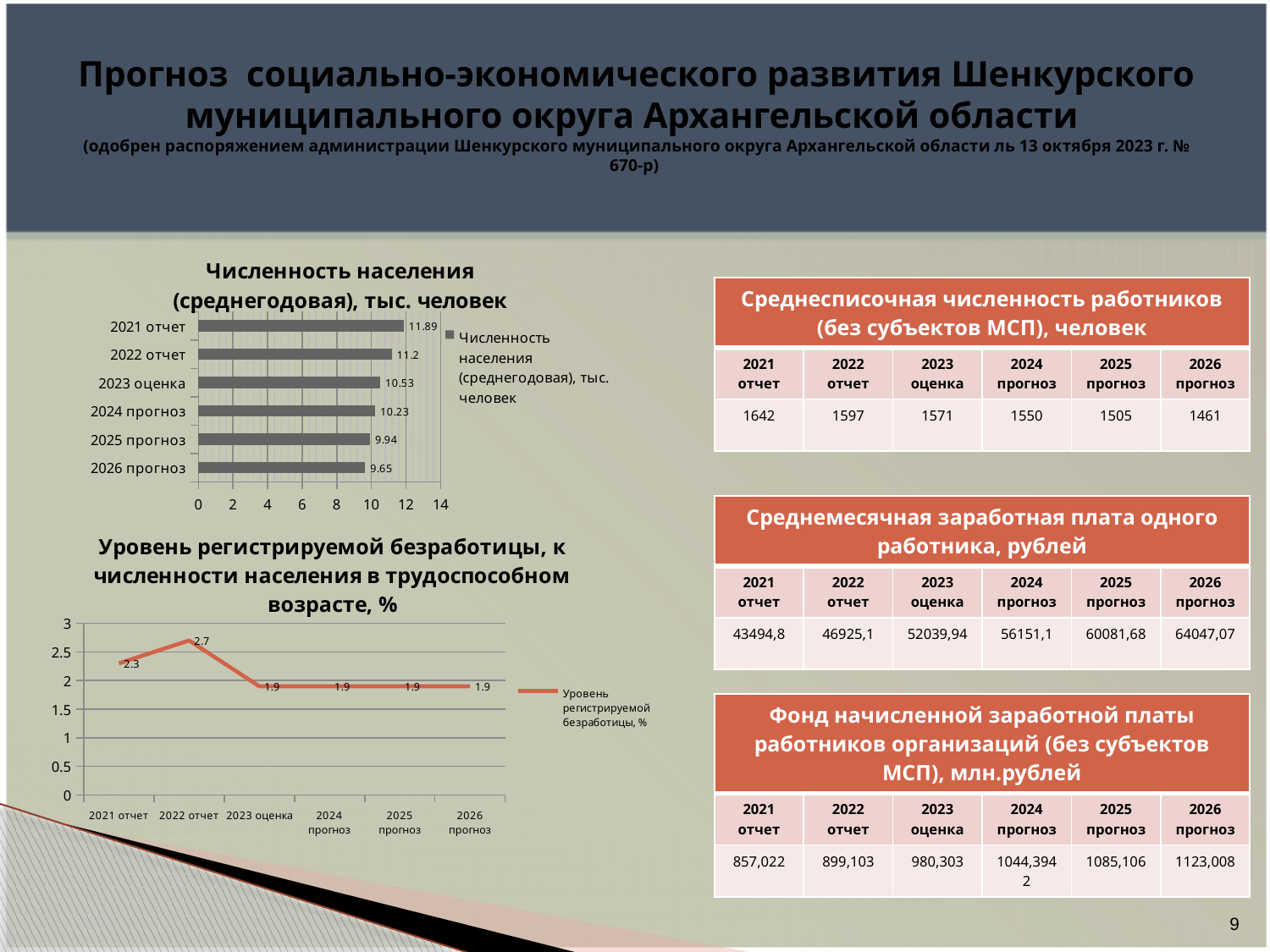
In the chart 'Уровень регистрируемой безработицы, к численности населения в трудоспособном возрасте, %', what is the value for 2021 отчет? 2.3 In the chart 'Численность населения (среднегодовая), тыс. человек', which category has the highest value? 2021 отчет In the chart 'Численность населения (среднегодовая), тыс. человек', do the values rise or fall from 2021 отчет to 2026 прогноз? fall In the chart 'Уровень регистрируемой безработицы, к численности населения в трудоспособном возрасте, %', which year has the highest value? 2022 отчет In the chart 'Численность населения (среднегодовая), тыс. человек', how many categories are shown? 6 In the chart 'Численность населения (среднегодовая), тыс. человек', what is the value for 2026 прогноз? 9.65 In the chart 'Численность населения (среднегодовая), тыс. человек', what is the value for 2021 отчет? 11.89 What kind of chart is 'Численность населения (среднегодовая), тыс. человек'? bar chart What kind of chart is 'Уровень регистрируемой безработицы, к численности населения в трудоспособном возрасте, %'? line chart In the chart 'Численность населения (среднегодовая), тыс. человек', what is the difference between the values for 2021 отчет and 2026 прогноз? 2.24 In the chart 'Численность населения (среднегодовая), тыс. человек', which category has the lowest value? 2026 прогноз In the chart 'Уровень регистрируемой безработицы, к численности населения в трудоспособном возрасте, %', what is the value for 2022 отчет? 2.7